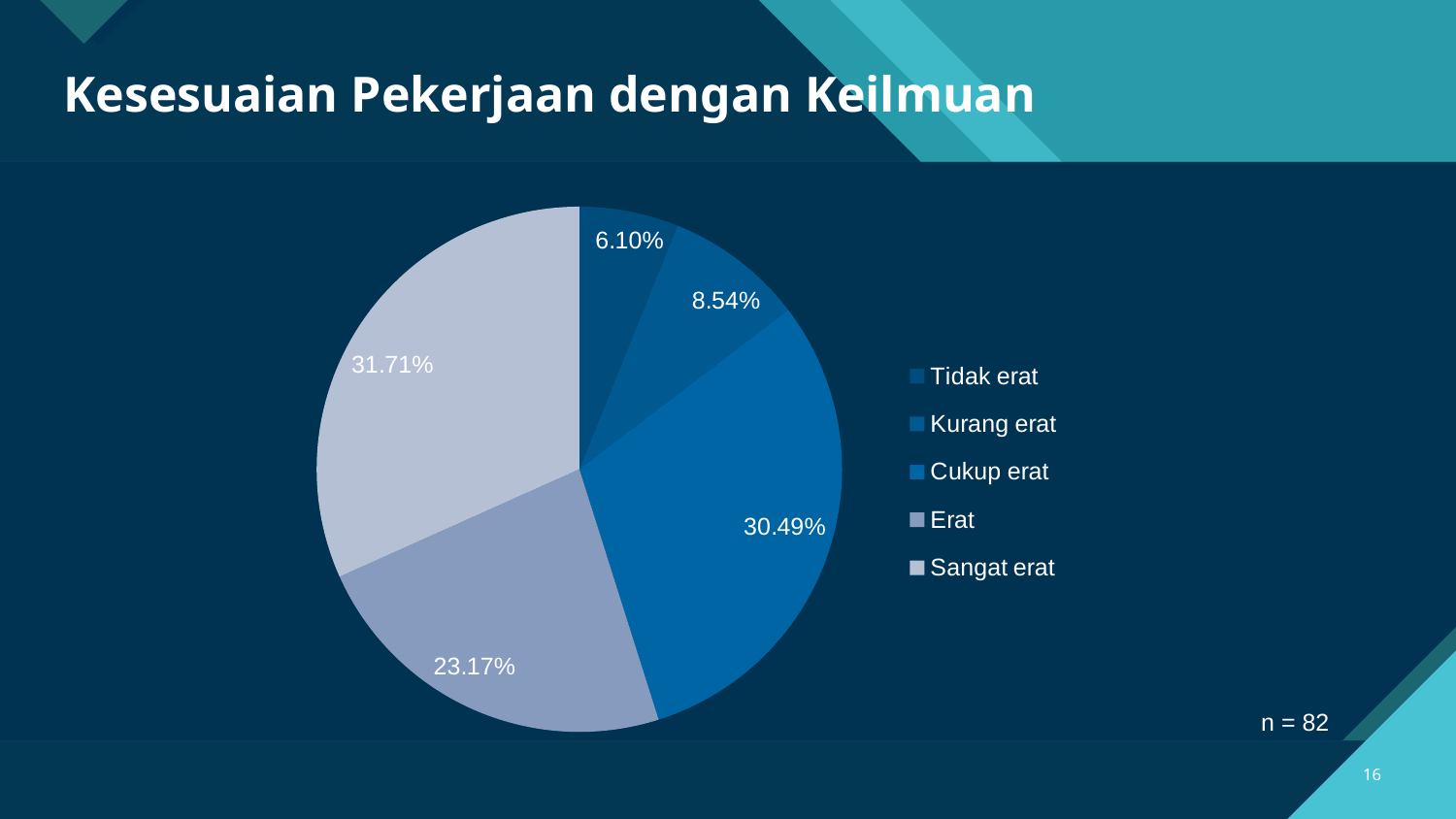
How many categories does the legend list? 5 What share of the pie is labelled for Cukup erat? 30.49% What kind of chart is shown on the slide? pie chart Which category has the smallest slice of the pie? Tidak erat What share of the pie is labelled for Tidak erat? 6.10% What is the title of the chart on the slide? Kesesuaian Pekerjaan dengan Keilmuan What share of the pie is labelled for Sangat erat? 31.71% What is the difference between the shares for Cukup erat and Erat? 7.32% What sample size (n) is stated on the slide? n = 82 Which category has the largest slice of the pie? Sangat erat